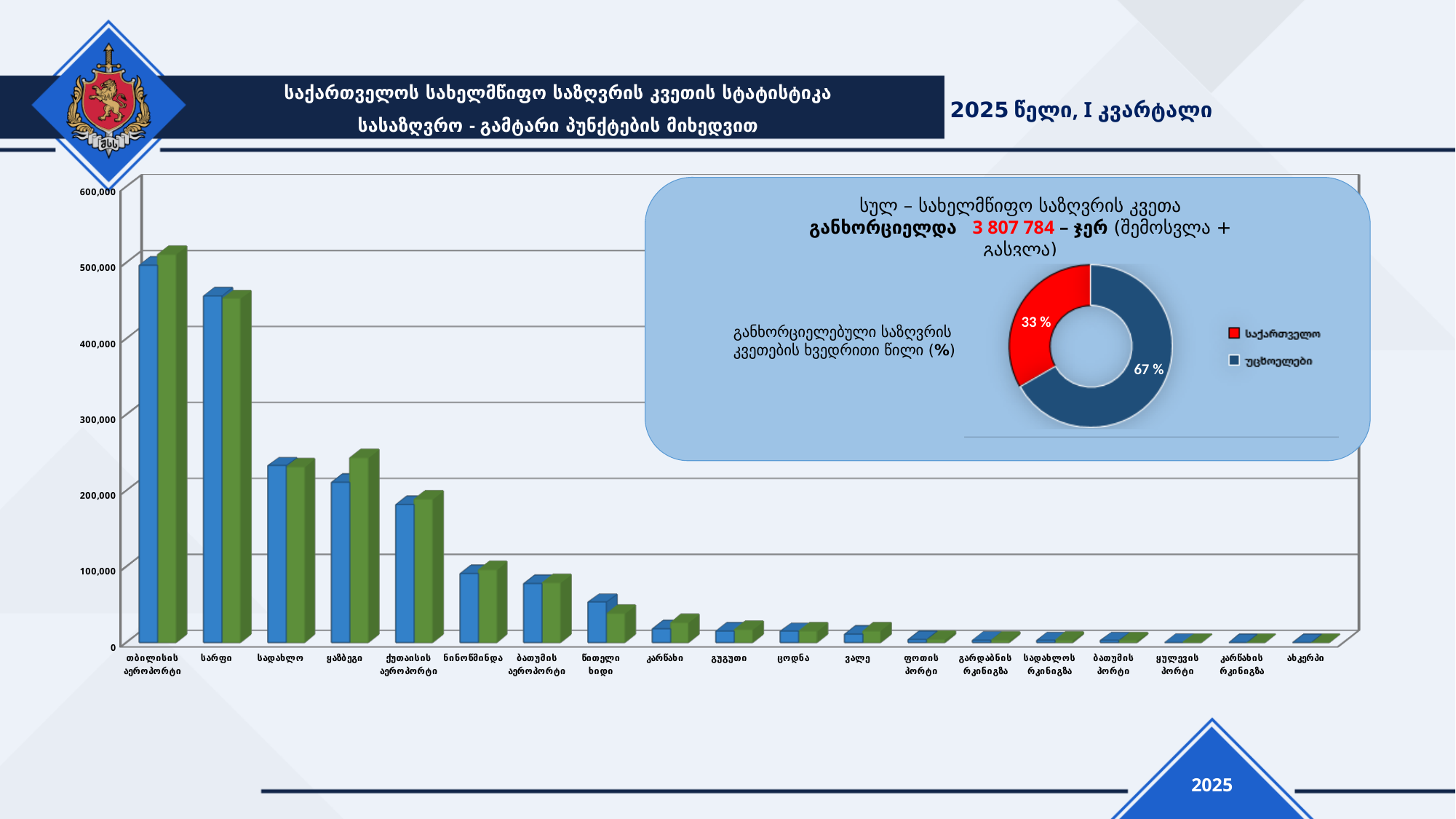
In the bar chart on the left, is the green bar for ყაზბეგი greater or less than 200,000? greater In the bar chart on the left, which category has the highest values? თბილისის აეროპორტი In the doughnut chart inside the blue box, what share is shown for საქართველო? 33 % In the bar chart on the left, is the blue bar for თბილისის აეროპორტი greater or less than 400,000? greater What kind of chart is the large chart on the left side of the slide? bar chart In the bar chart on the left, do the values generally rise or fall moving from left to right along the x axis? fall In the bar chart on the left, which has a larger blue bar, თბილისის აეროპორტი or სარფი? თბილისის აეროპორტი How many entries does the legend of the doughnut chart in the blue box list? 2 In the bar chart on the left, is the green bar for სარფი greater or less than 500,000? less In the doughnut chart inside the blue box, what share is shown for უცხოელები? 67 % In the doughnut chart inside the blue box, what is the difference between the share for უცხოელები and the share for საქართველო? 34 % How many categories are shown on the x axis of the bar chart on the left? 19